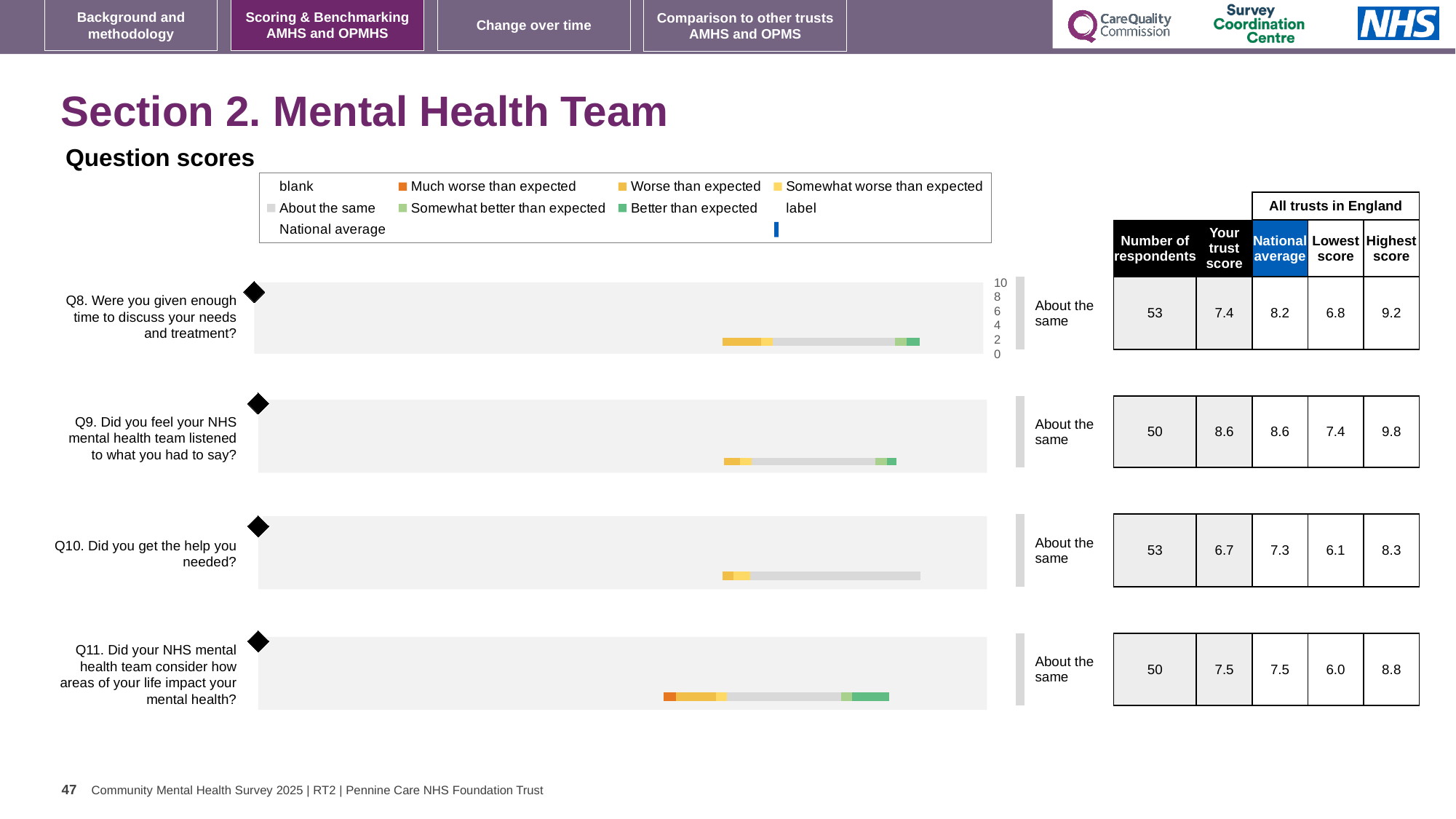
For Q10, which is larger: the trust score or the national average? national average What is the highest score among all trusts in England for Q11? 8.8 What kind of chart is used to show the question scores for Q8 to Q11? bar chart For Q11, what is the difference between the highest score and the lowest score among all trusts in England? 2.8 For Q8, how much higher is the national average than the trust score? 0.8 Which question has the highest 'Your trust score'? Q9 How many respondents answered Q10 (Did you get the help you needed)? 53 Which question has the lowest 'Your trust score'? Q10 What benchmark category label is shown next to each of the four question charts? About the same How many questions (Q8 to Q11) have a score bar plotted on the slide? 4 What is the national average score for Q9 (Did you feel your NHS mental health team listened to what you had to say)? 8.6 What is the 'Your trust score' value for Q8 (Were you given enough time to discuss your needs and treatment)? 7.4